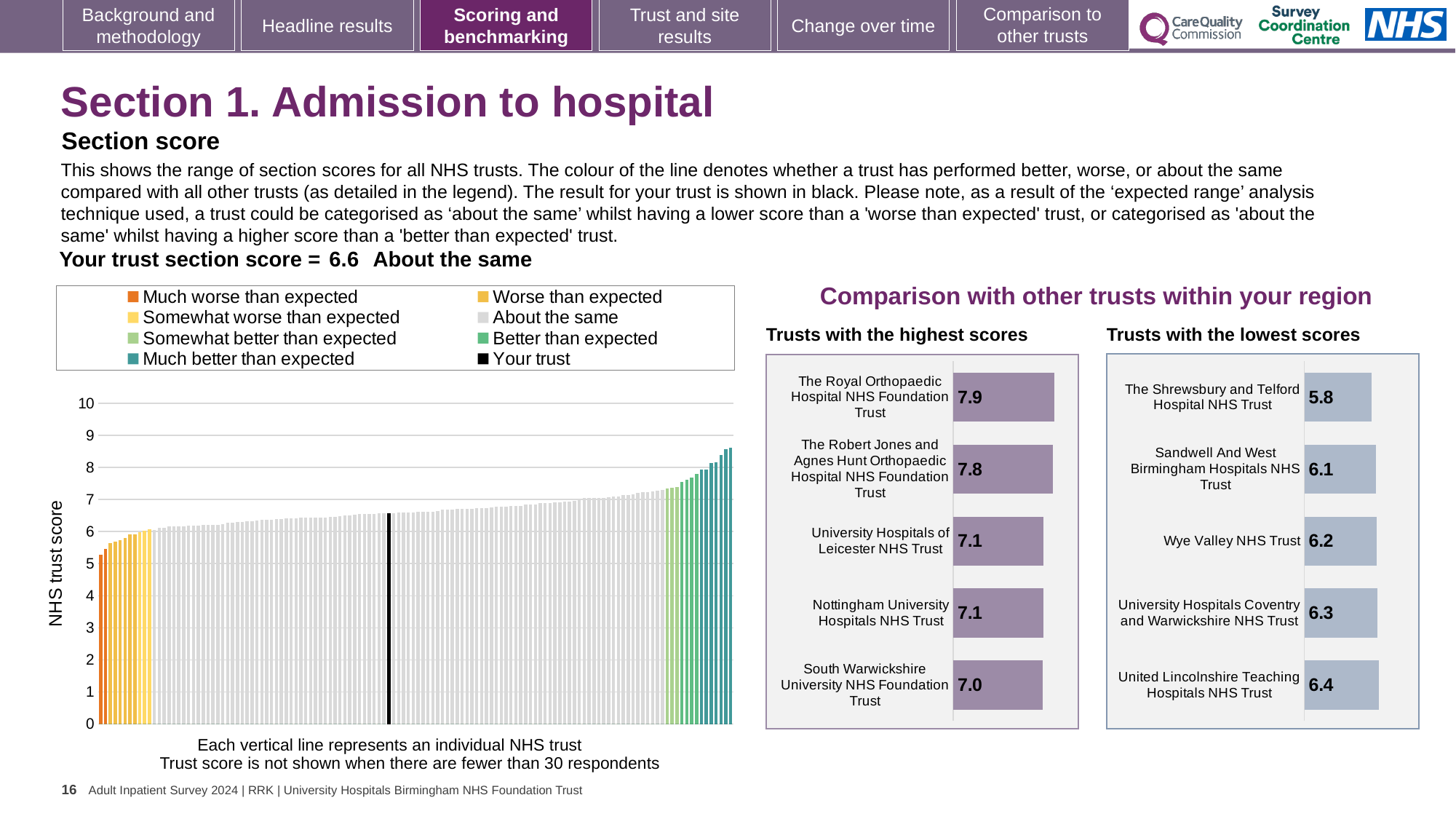
How many entries does the legend of the main NHS trust score chart on the left list? 8 In the 'Trusts with the lowest scores' chart, which has the larger score: Sandwell And West Birmingham Hospitals NHS Trust or University Hospitals Coventry and Warwickshire NHS Trust? University Hospitals Coventry and Warwickshire NHS Trust In the 'Trusts with the lowest scores' chart, which trust has the lowest score? The Shrewsbury and Telford Hospital NHS Trust In the 'Trusts with the highest scores' chart, what is the score for South Warwickshire University NHS Foundation Trust? 7.0 In the 'Trusts with the highest scores' chart, which trust has the highest score? The Royal Orthopaedic Hospital NHS Foundation Trust In the 'Trusts with the highest scores' chart, what is the difference between the scores of The Royal Orthopaedic Hospital NHS Foundation Trust and The Robert Jones and Agnes Hunt Orthopaedic Hospital NHS Foundation Trust? 0.1 In the main chart on the left, do the NHS trust scores rise or fall from left to right along the x axis? Rise In the main chart on the left, what is the section score for your trust (shown in black)? 6.6 In the 'Trusts with the highest scores' chart, what is the score for The Royal Orthopaedic Hospital NHS Foundation Trust? 7.9 How many trusts are shown in the 'Trusts with the highest scores' chart? 5 In the 'Trusts with the lowest scores' chart, what is the score for Wye Valley NHS Trust? 6.2 What kind of chart is the main chart on the left showing NHS trust scores? Bar chart